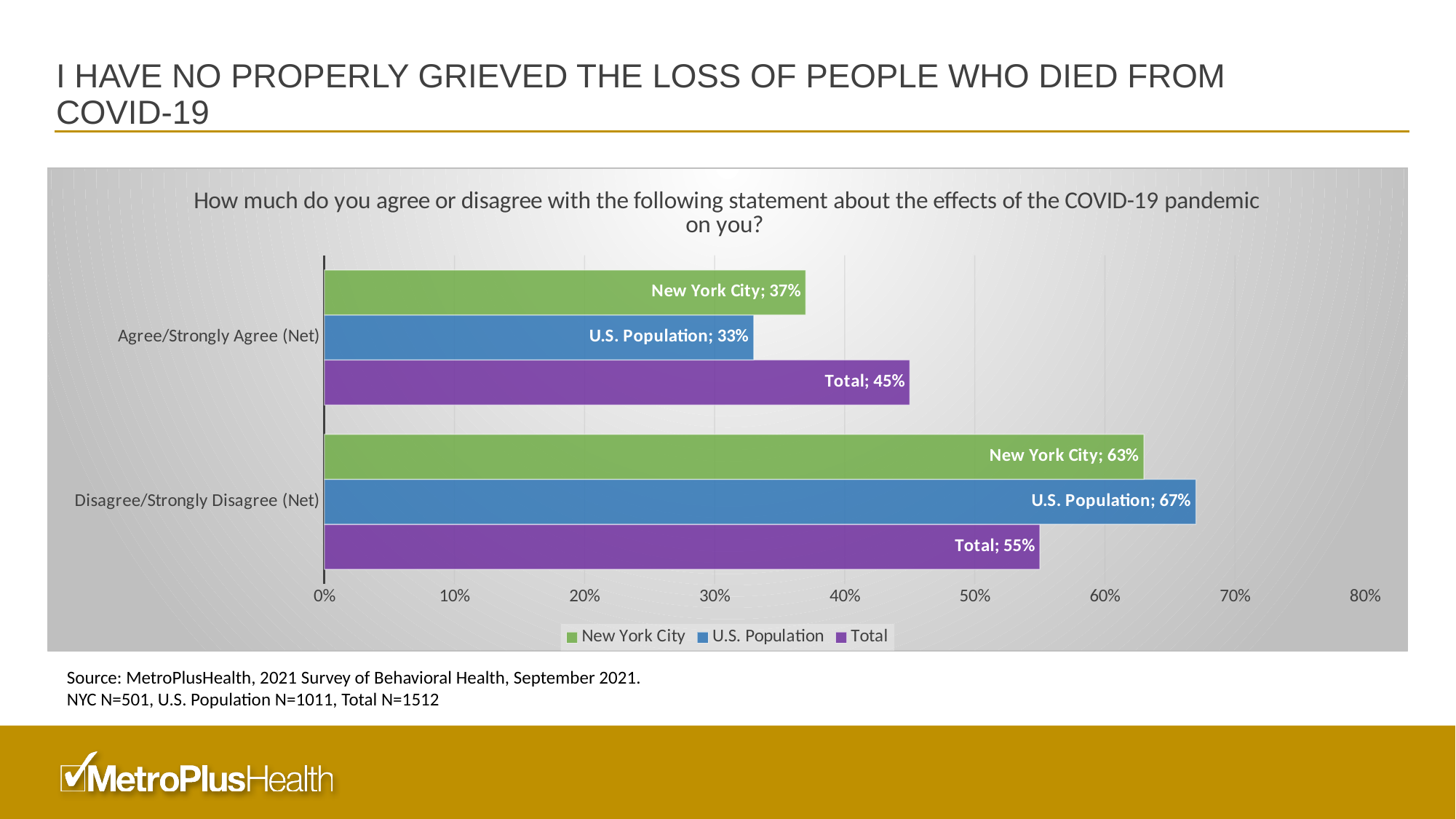
Which series has the lowest value in the Agree/Strongly Agree (Net) category? U.S. Population What is the Total value for Agree/Strongly Agree (Net)? 45% What colour represents the Total series? Purple What is the value for U.S. Population in the Disagree/Strongly Disagree (Net) category? 67% Which series has the highest value in the Disagree/Strongly Disagree (Net) category? U.S. Population Is the Total value for Disagree/Strongly Disagree (Net) greater or less than 50%? greater Which is larger for New York City: Agree/Strongly Agree (Net) or Disagree/Strongly Disagree (Net)? Disagree/Strongly Disagree (Net) What is the difference between the U.S. Population values for Disagree/Strongly Disagree (Net) and Agree/Strongly Agree (Net)? 34% How many categories are shown on the vertical axis? 2 What is the value for New York City in the Agree/Strongly Agree (Net) category? 37% How many series does the legend list? 3 What kind of chart is shown on the slide? Bar chart